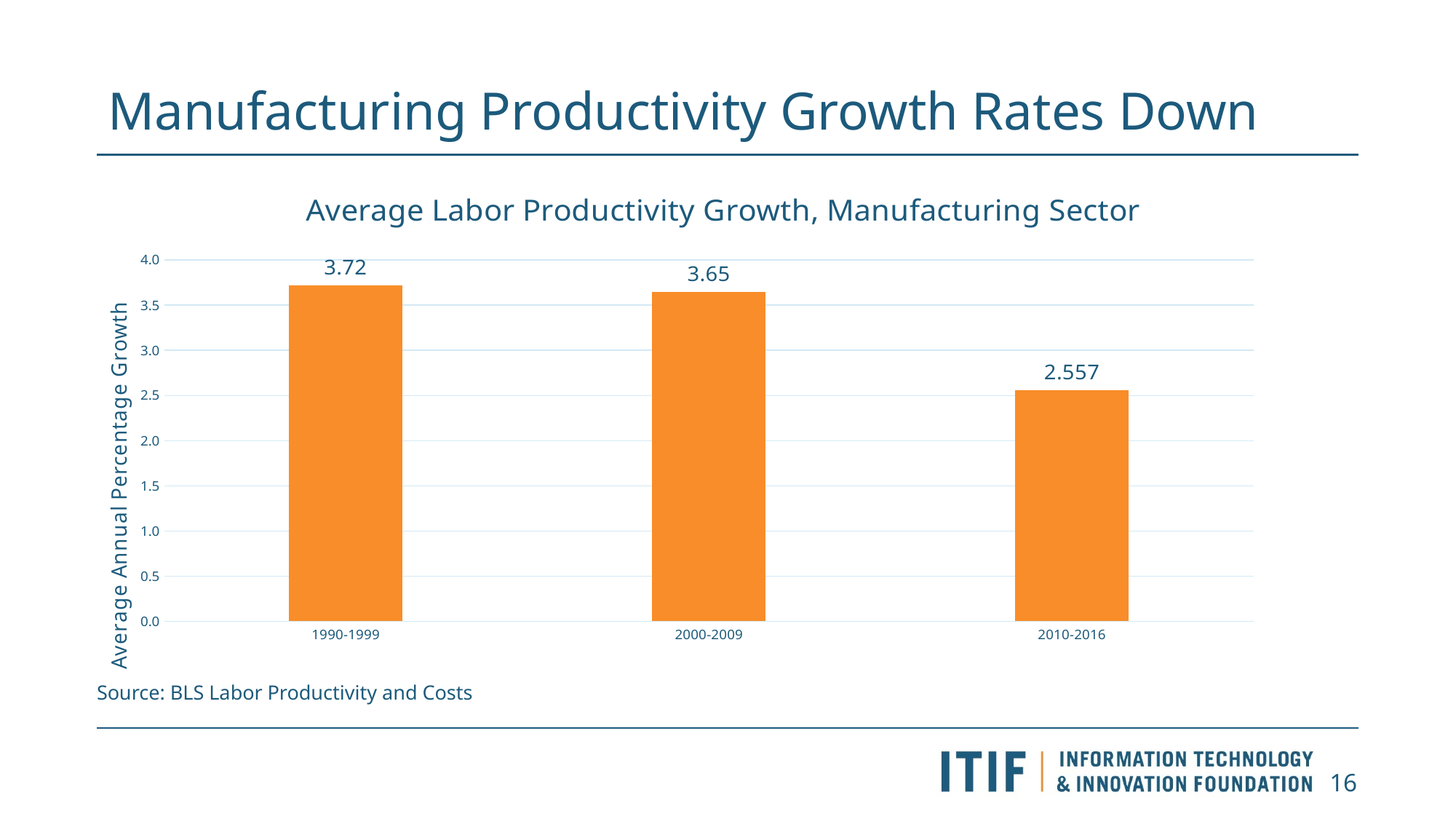
What is the difference between the values for 1990-1999 and 2000-2009? 0.07 What is the average labor productivity growth for 2000-2009? 3.65 Which period has the lowest average labor productivity growth? 2010-2016 Which is larger, the value for 2000-2009 or the value for 2010-2016? 2000-2009 What is the average labor productivity growth for 1990-1999? 3.72 What kind of chart is shown on the slide? bar chart What is the average labor productivity growth for 2010-2016? 2.557 Which period has the highest average labor productivity growth? 1990-1999 Is the value for 2010-2016 greater or less than 3.0? less What is the difference between the values for 2000-2009 and 2010-2016? 1.093 Do the values rise or fall from 1990-1999 to 2010-2016? fall How many periods are shown on the chart? 3